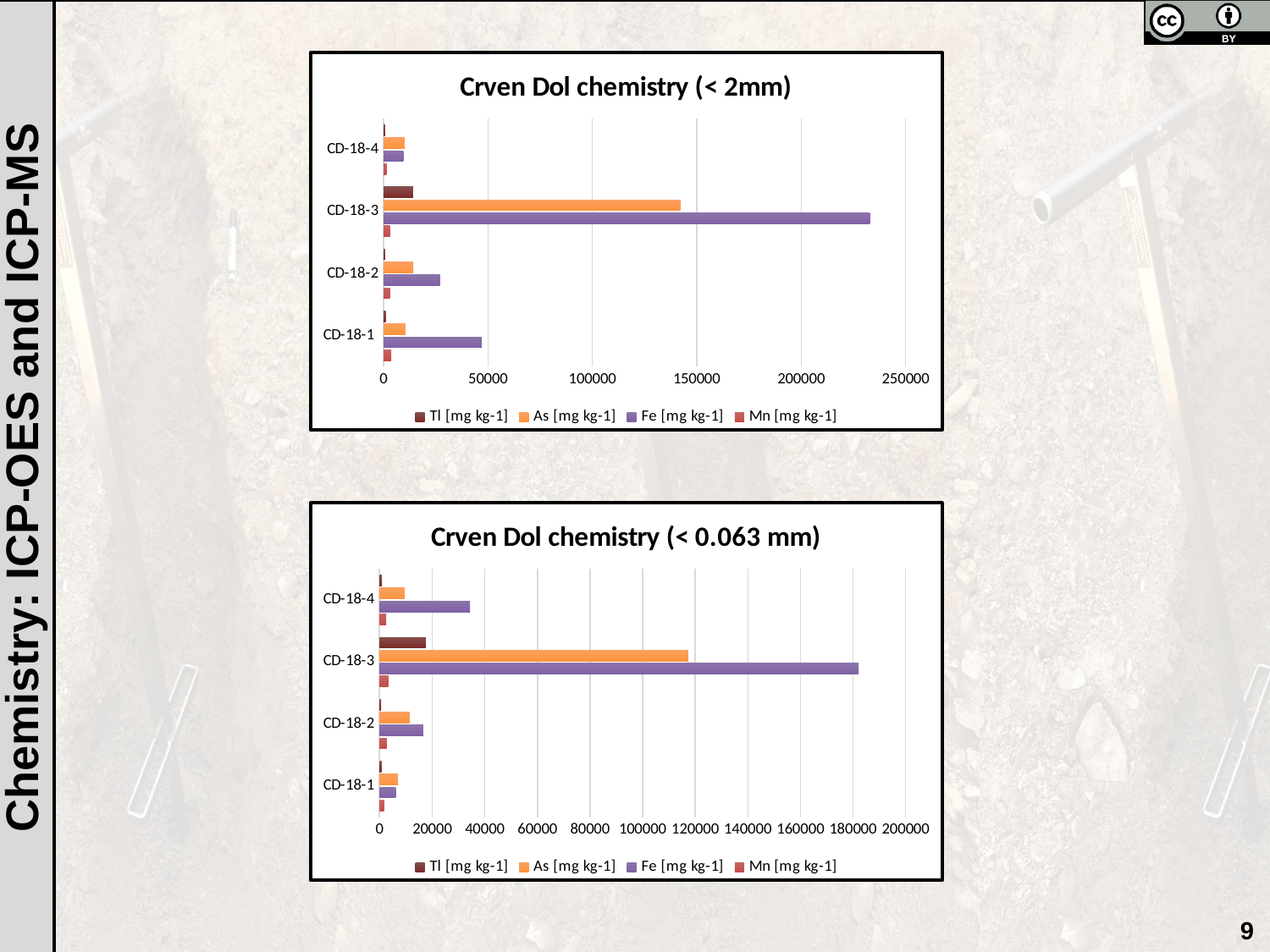
In the top chart 'Crven Dol chemistry (< 2mm)', is the As [mg kg-1] value for CD-18-3 greater or less than 150000? less What kind of chart is the top chart, 'Crven Dol chemistry (< 2mm)'? bar chart In the top chart 'Crven Dol chemistry (< 2mm)', which sample has the highest Fe [mg kg-1] value? CD-18-3 In the bottom chart 'Crven Dol chemistry (< 0.063 mm)', which sample has the lowest Fe [mg kg-1] value? CD-18-1 What is the title of the bottom chart on the slide? Crven Dol chemistry (< 0.063 mm) In the top chart 'Crven Dol chemistry (< 2mm)', how many samples are shown on the vertical axis? 4 In the top chart 'Crven Dol chemistry (< 2mm)', how many series does the legend list? 4 In the top chart 'Crven Dol chemistry (< 2mm)', which sample has the larger Fe [mg kg-1] value, CD-18-1 or CD-18-2? CD-18-1 In the top chart 'Crven Dol chemistry (< 2mm)', is the Fe [mg kg-1] value for CD-18-3 greater or less than 200000? greater In the bottom chart 'Crven Dol chemistry (< 0.063 mm)', is the As [mg kg-1] value for CD-18-3 greater or less than 100000? greater In the bottom chart 'Crven Dol chemistry (< 0.063 mm)', which sample has the larger Fe [mg kg-1] value, CD-18-4 or CD-18-2? CD-18-4